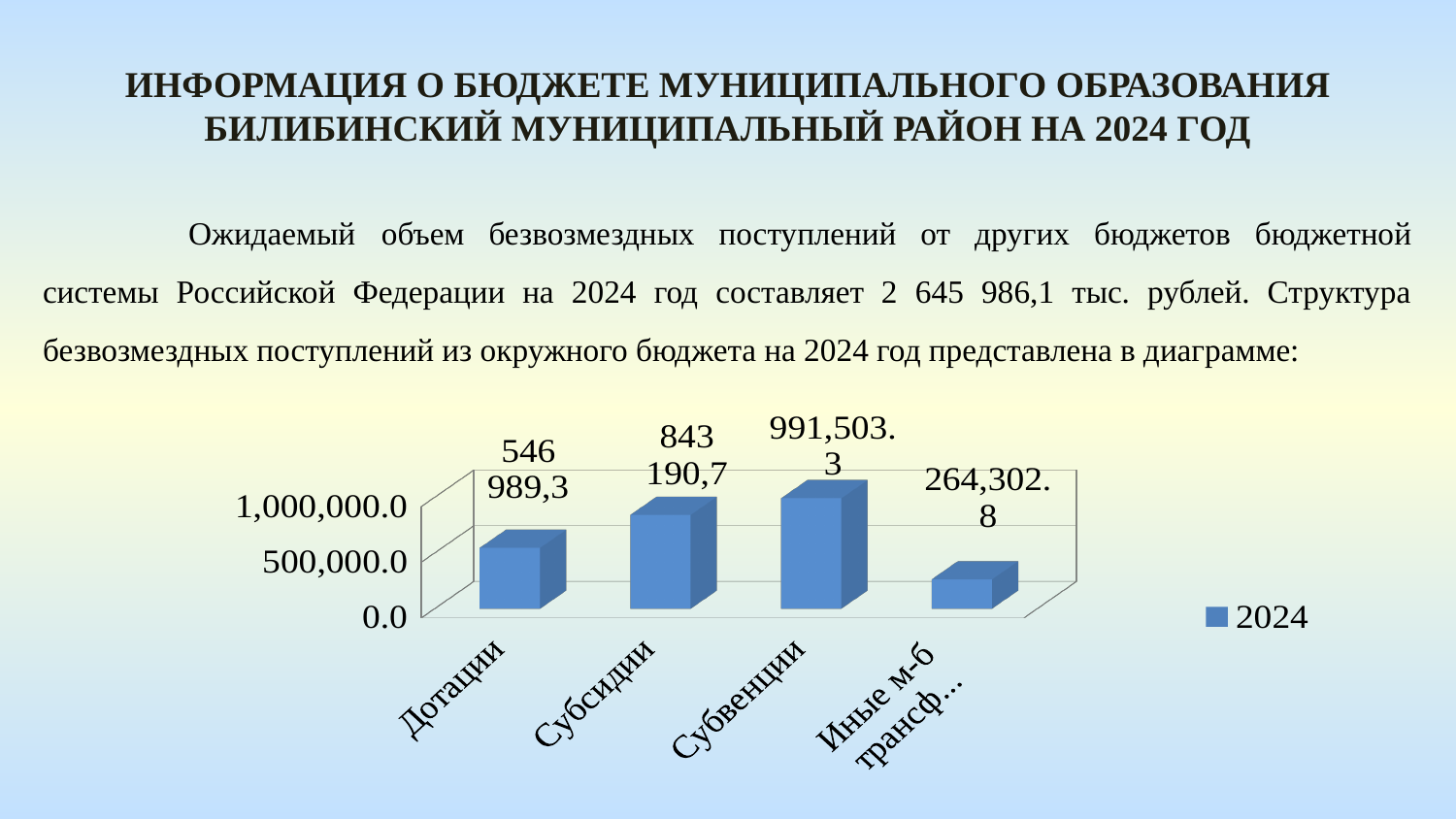
What is the value for the fourth category (Иные м-б трансф...)? 264,302.8 Which is larger, Дотации or Субсидии? Субсидии How many series does the legend list? 1 What is the value for Субвенции? 991,503.3 How many categories are shown in the chart? 4 Which category has the lowest value? Иные м-б трансф... Is the value for Иные м-б трансф... greater or less than 500,000.0? less What is the value for Дотации? 546 989,3 Which category has the highest value? Субвенции What type of chart is shown? bar chart Is the value for Субсидии greater or less than 500,000.0? greater What is the value for Субсидии? 843 190,7